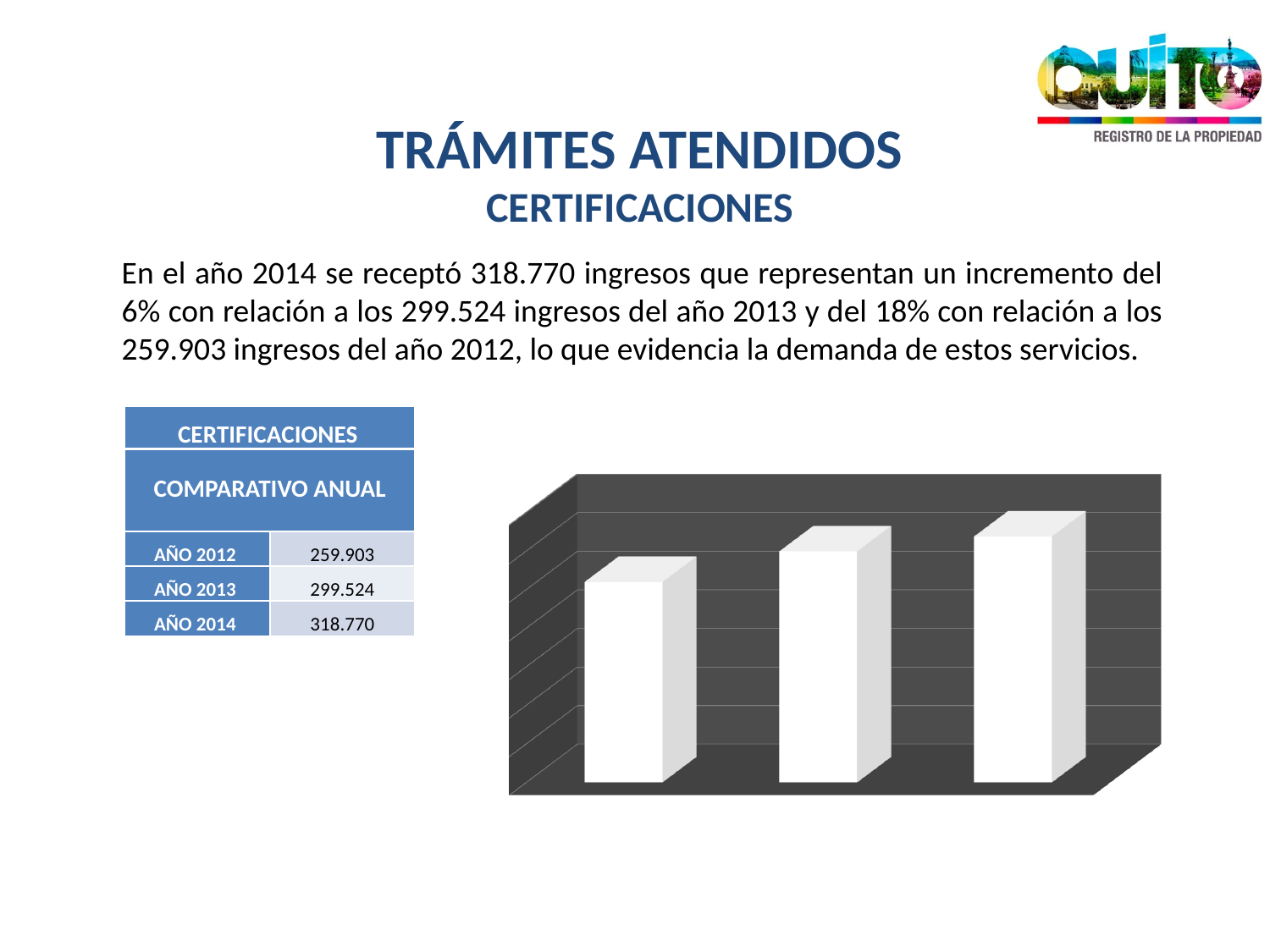
What is the title shown above the comparativo anual table? CERTIFICACIONES According to the table accompanying the chart, what is the value for AÑO 2013? 299.524 How many bars does the chart show? 3 Which year has the lowest value in the comparativo anual table? AÑO 2012 Which bar is the tallest in the chart: the leftmost, middle or rightmost? rightmost Is the middle bar taller or shorter than the leftmost bar? taller What kind of chart is shown on the slide? bar chart Do the bar heights rise or fall from left to right across the chart? rise According to the table accompanying the chart, what is the value for AÑO 2014? 318.770 Which year has the highest value in the comparativo anual table? AÑO 2014 Which bar is the shortest in the chart: the leftmost, middle or rightmost? leftmost According to the table accompanying the chart, what is the value for AÑO 2012? 259.903